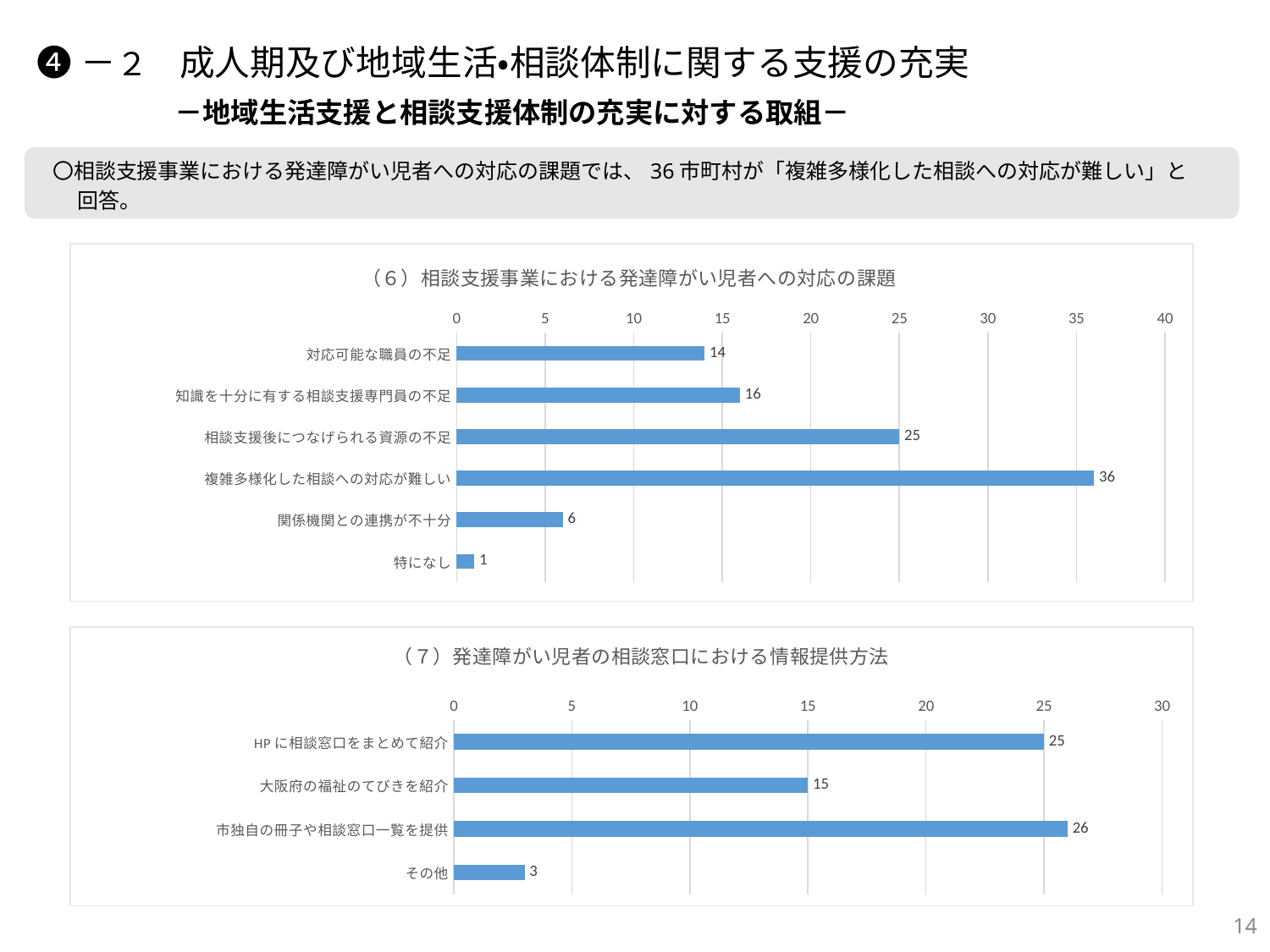
What kind of chart is the bottom chart (（７）発達障がい児者の相談窓口における情報提供方法)? Bar chart In the top chart (（６）相談支援事業における発達障がい児者への対応の課題), which category has the lowest value? 特になし In the top chart (（６）相談支援事業における発達障がい児者への対応の課題), what is the value for 複雑多様化した相談への対応が難しい? 36 In the bottom chart (（７）発達障がい児者の相談窓口における情報提供方法), which is larger: HP に相談窓口をまとめて紹介 or 市独自の冊子や相談窓口一覧を提供? 市独自の冊子や相談窓口一覧を提供 In the top chart (（６）相談支援事業における発達障がい児者への対応の課題), what is the value for 関係機関との連携が不十分? 6 In the bottom chart (（７）発達障がい児者の相談窓口における情報提供方法), what is the difference between 市独自の冊子や相談窓口一覧を提供 and その他? 23 What is the title of the top chart? （６）相談支援事業における発達障がい児者への対応の課題 In the top chart (（６）相談支援事業における発達障がい児者への対応の課題), which category has the highest value? 複雑多様化した相談への対応が難しい In the bottom chart (（７）発達障がい児者の相談窓口における情報提供方法), how many categories are shown? 4 In the bottom chart (（７）発達障がい児者の相談窓口における情報提供方法), what is the value for 大阪府の福祉のてびきを紹介? 15 In the top chart (（６）相談支援事業における発達障がい児者への対応の課題), how many categories are shown? 6 In the top chart (（６）相談支援事業における発達障がい児者への対応の課題), what is the difference between 相談支援後につなげられる資源の不足 and 対応可能な職員の不足? 11